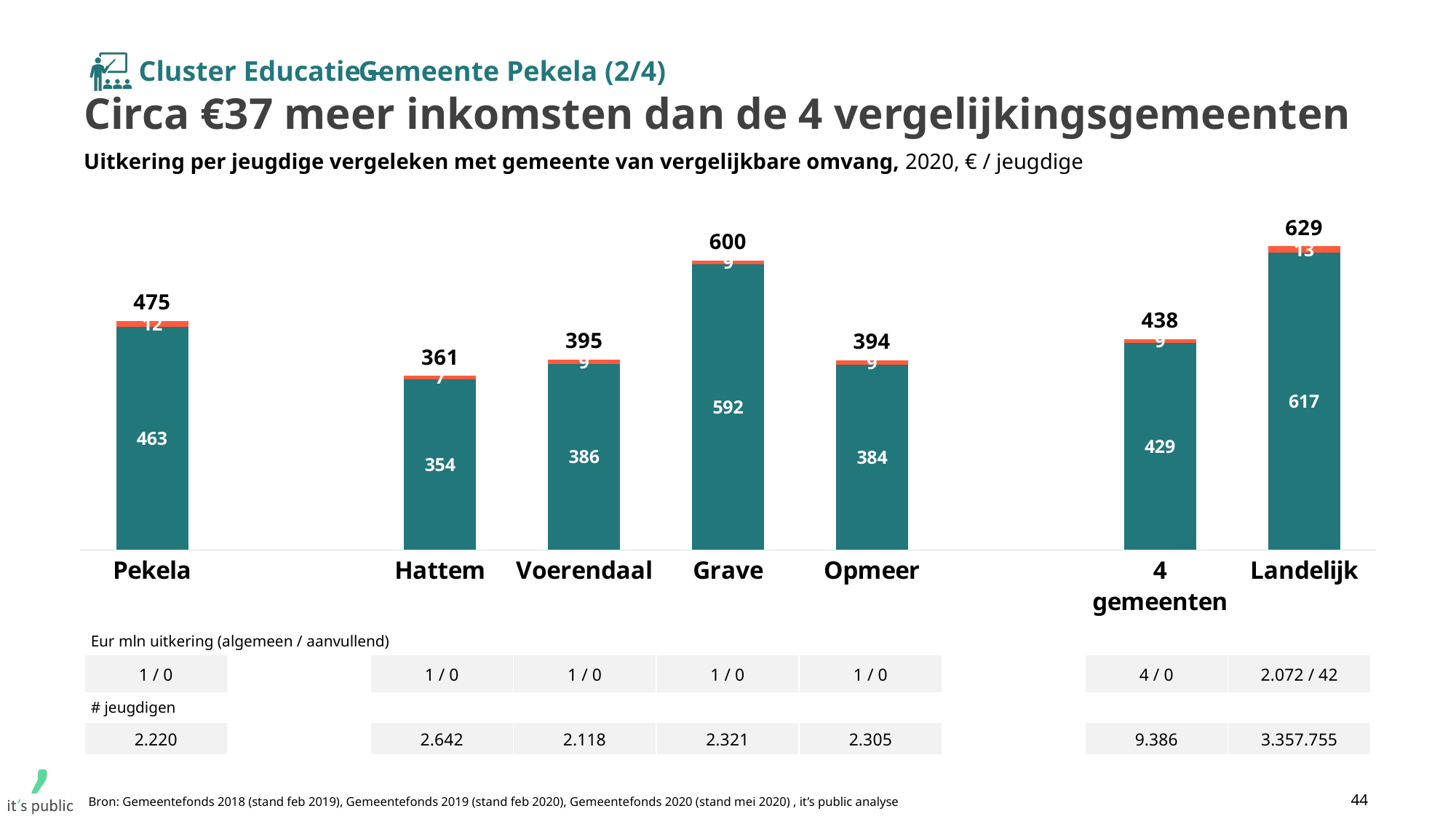
Which category has the highest total value? Landelijk What kind of chart is shown on the slide? Stacked bar chart Which has a larger total, Voerendaal or Opmeer? Voerendaal What is the difference between the total for Pekela and the total for 4 gemeenten? 37 What is the value of the large teal segment for Hattem? 354 What is the total value shown above the bar for Grave? 600 What is the total value shown above the bar for Pekela? 475 What is the value of the large teal segment for Landelijk? 617 How many categories are shown on the x axis of the chart? 7 What is the number of jeugdigen listed in the table below the chart for Pekela? 2.220 Which category has the lowest total value? Hattem What is the total value shown above the bar for 4 gemeenten? 438